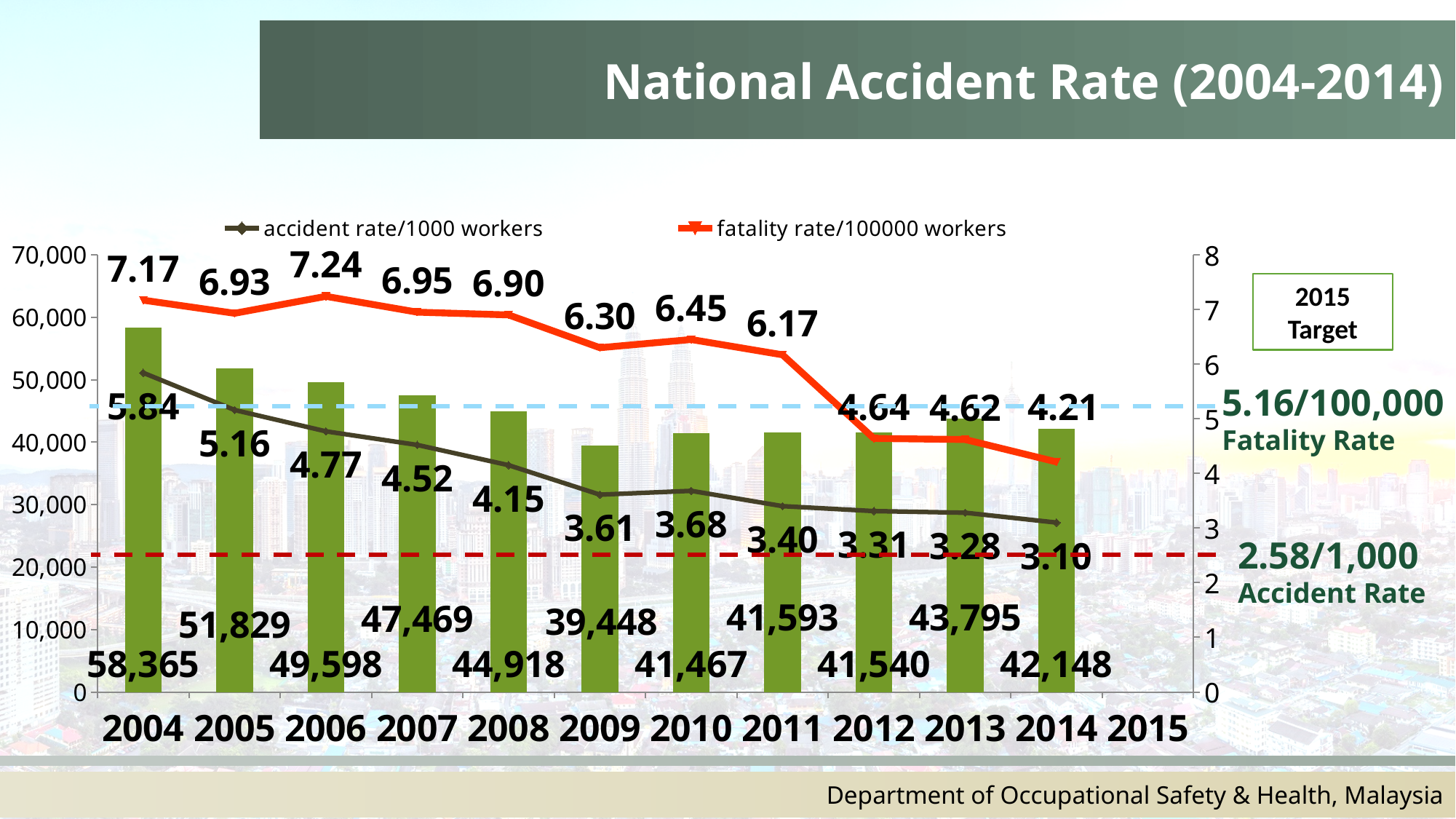
Which year has the highest fatality rate per 100,000 workers? 2006 What is the accident rate per 1,000 workers in 2009? 3.61 What is the fatality rate per 100,000 workers in 2006? 7.24 How many series does the legend list? 2 What is the 2015 target fatality rate shown on the slide? 5.16/100,000 Does the accident rate per 1,000 workers generally rise or fall from 2004 to 2014? fall What is the difference between the fatality rate in 2011 and in 2012? 1.53 Which year has the lowest accident rate per 1,000 workers? 2014 What is the value printed on the bar for 2004? 58,365 Which year has the lowest bar value? 2009 Which is larger, the bar value for 2013 or for 2014? 2013 How many years have bars plotted on the chart? 11